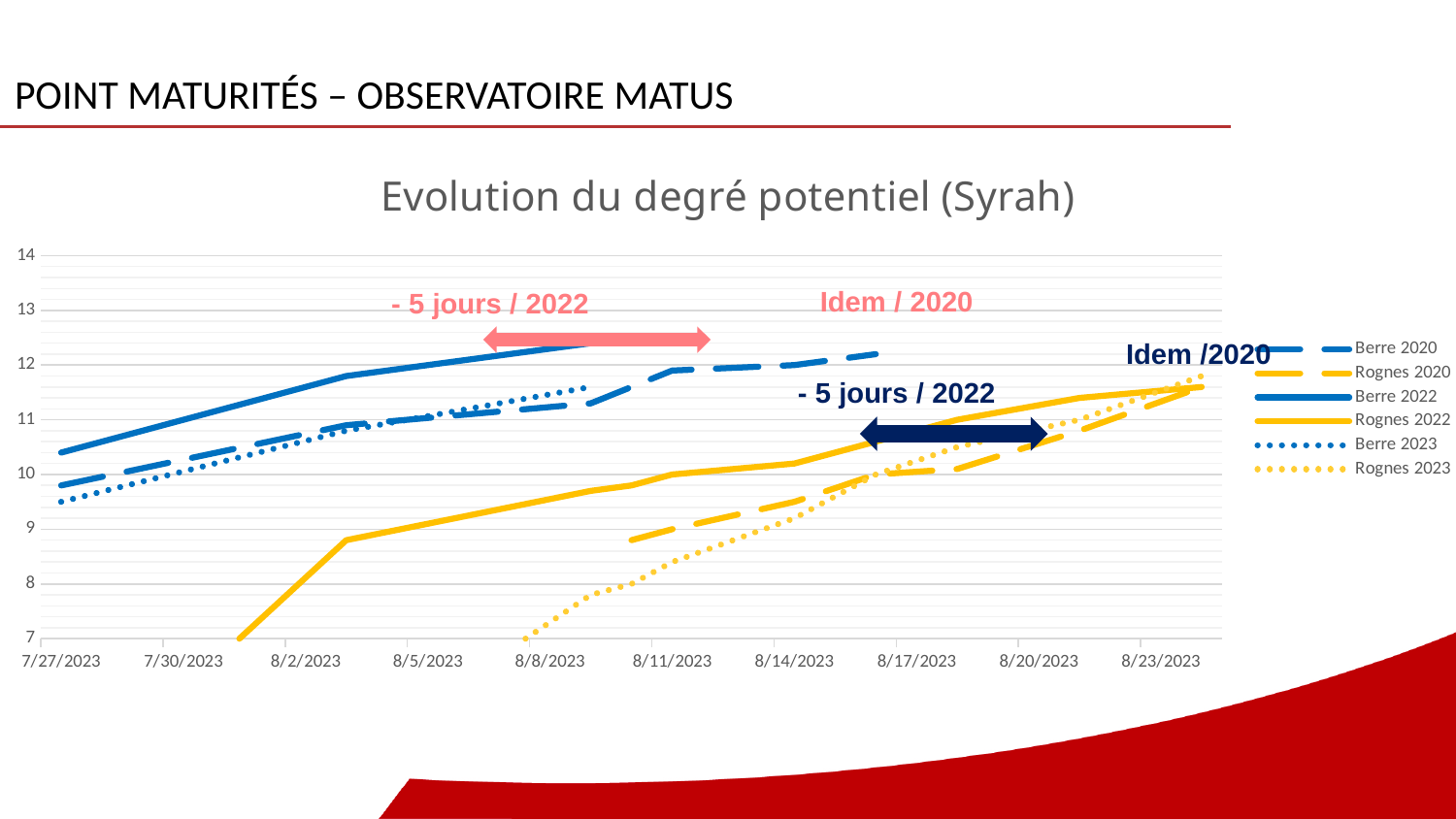
What is the title of the chart? Evolution du degré potentiel (Syrah) How many date labels are shown on the x axis? 10 Does the Berre 2022 line rise or fall from 7/27/2023 to 8/8/2023? rise What kind of chart is shown on the slide? line chart How many series does the legend list? 6 Is the value for Berre 2022 at 7/27/2023 greater or less than 10? greater Is the value for Rognes 2022 at 8/23/2023 greater or less than 11? greater Is the value for Berre 2022 at 8/8/2023 greater or less than 12? greater At 8/5/2023, which is higher: Berre 2022 or Rognes 2022? Berre 2022 Which series has the highest value at 7/27/2023? Berre 2022